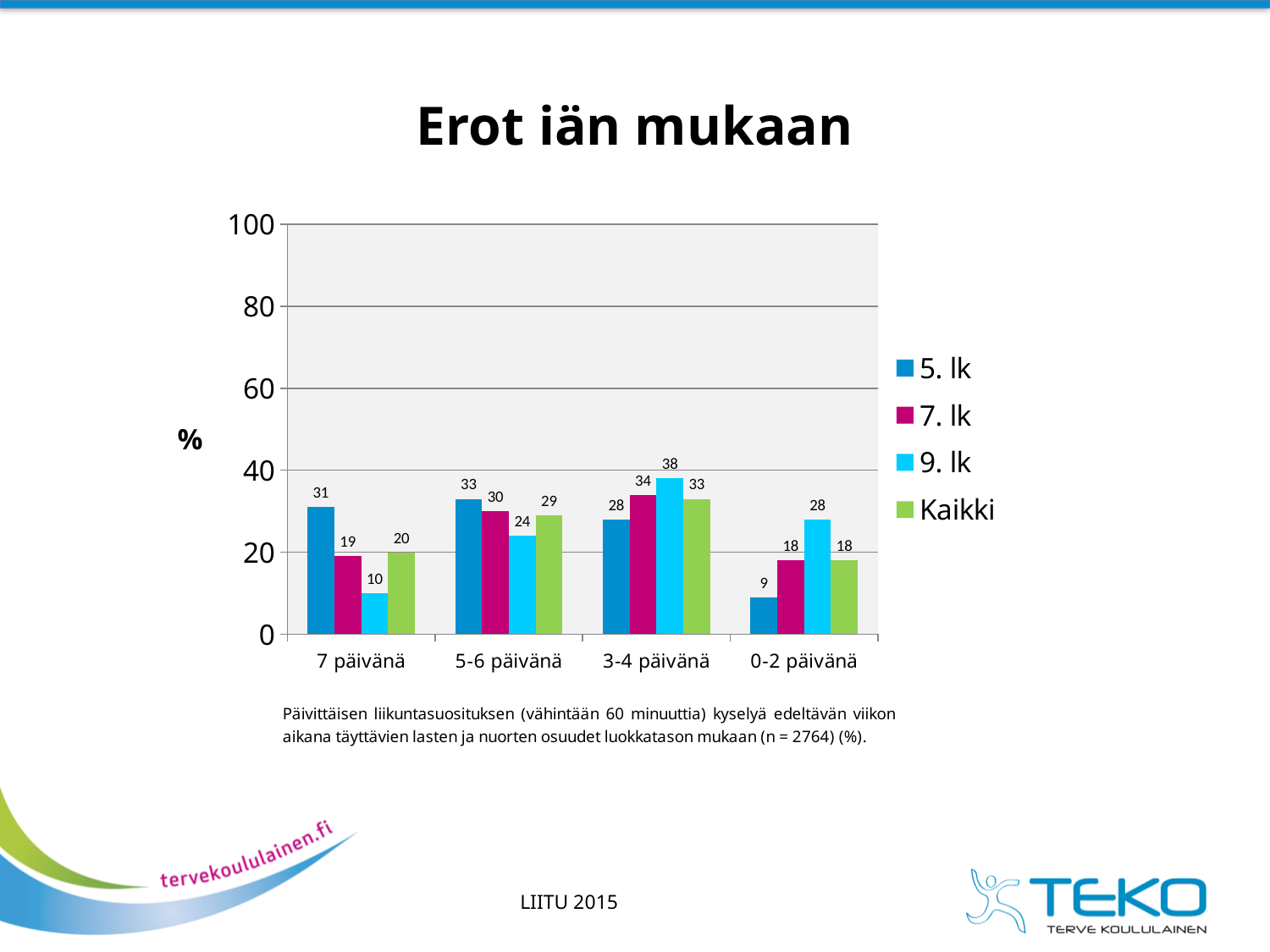
Do the values for 9. lk rise or fall from 7 päivänä to 3-4 päivänä? rise What is the value for Kaikki in the 0-2 päivänä category? 18 How many series does the legend list? 4 Which category has the lowest value for 9. lk? 7 päivänä How many categories are shown on the x axis? 4 What is the difference between the 5. lk and 9. lk values in the 7 päivänä category? 21 Which is larger in the 0-2 päivänä category, the value for 5. lk or the value for 9. lk? 9. lk Which category has the highest value for 5. lk? 5-6 päivänä What kind of chart is shown on the slide? bar chart What is the value for 5. lk in the 7 päivänä category? 31 What is the value for 9. lk in the 3-4 päivänä category? 38 What is the title of the chart? Erot iän mukaan